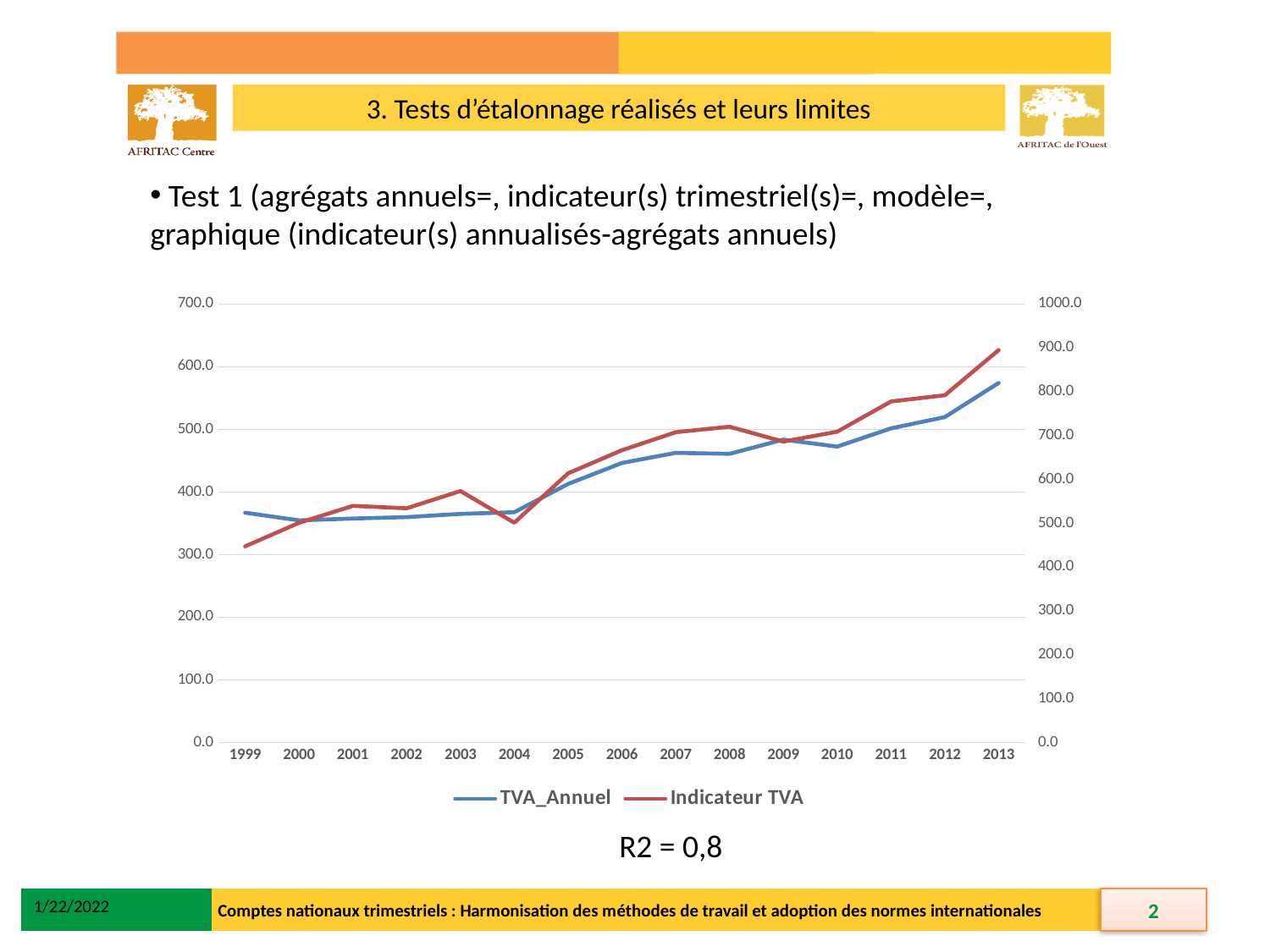
What is the last year shown on the x axis of the chart? 2013 What are the two series named in the chart legend? TVA_Annuel and Indicateur TVA In which year does the TVA_Annuel series reach its highest value? 2013 Does the TVA_Annuel series generally rise or fall from 1999 to 2013? rise Does the Indicateur TVA series generally rise or fall from 1999 to 2013? rise What kind of chart is shown on the slide? line chart Which colour is used for the Indicateur TVA line? red In which year does the Indicateur TVA series have its lowest value? 1999 What is the first year shown on the x axis of the chart? 1999 In which year does the Indicateur TVA series reach its highest value? 2013 How many years are plotted along the x axis of the chart? 15 How many series does the chart legend list? 2